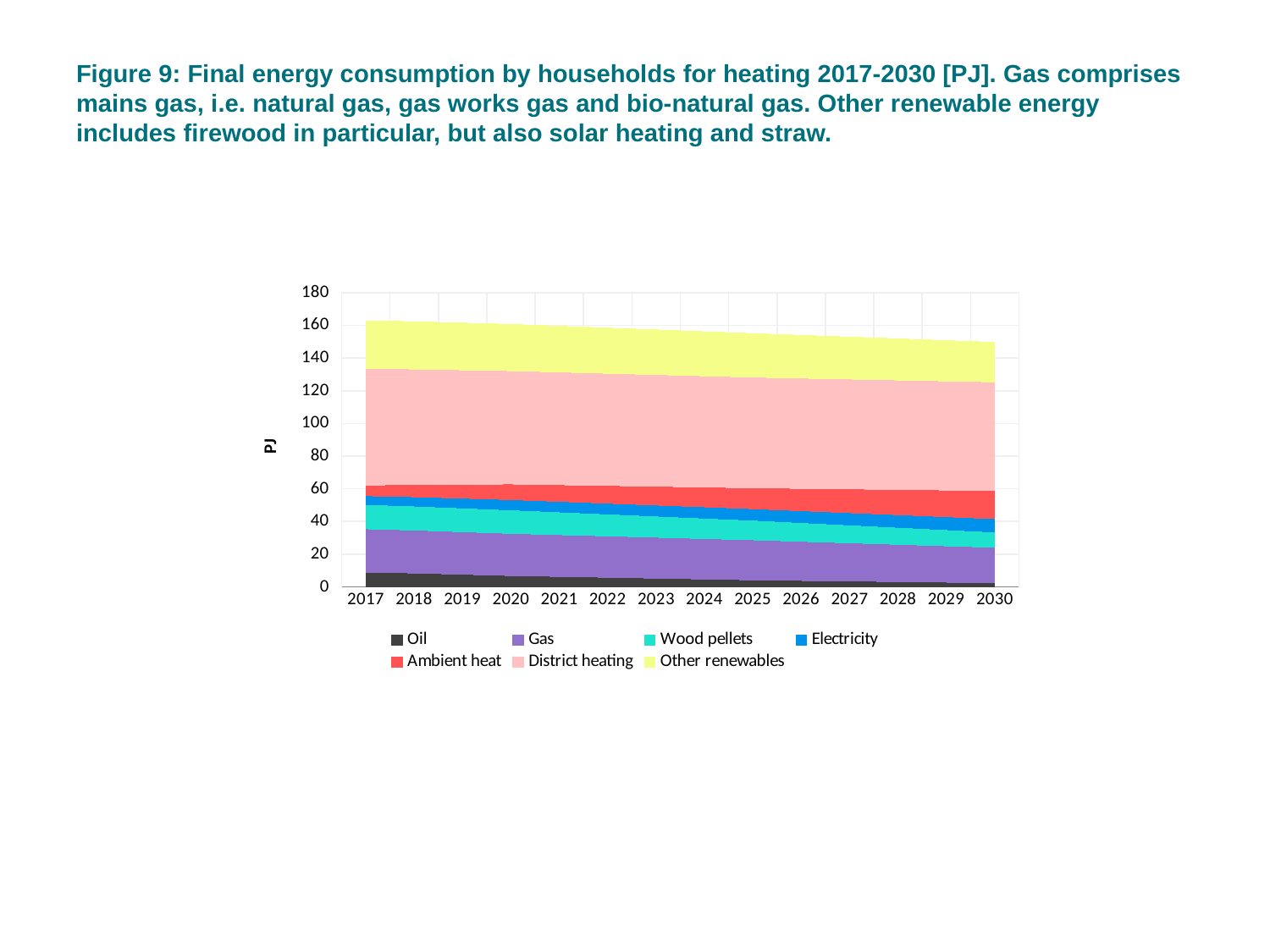
Is the total energy consumption in 2030 greater or less than 140 PJ? greater Which series accounts for the smallest share of household heating consumption in 2030? Oil Which series accounts for the largest share of household heating consumption across the period? District heating Does the total final energy consumption for heating rise or fall from 2017 to 2030? Fall Is the total energy consumption in 2017 greater or less than 140 PJ? greater What unit is shown on the y axis? PJ How many series does the legend list? 7 Is the total energy consumption in 2030 greater or less than 160 PJ? less Does the Oil series rise or fall between 2017 and 2030? Fall Which series is shown in yellow in the legend? Other renewables What kind of chart is shown on the slide? Stacked area chart How many years are shown along the x axis? 14